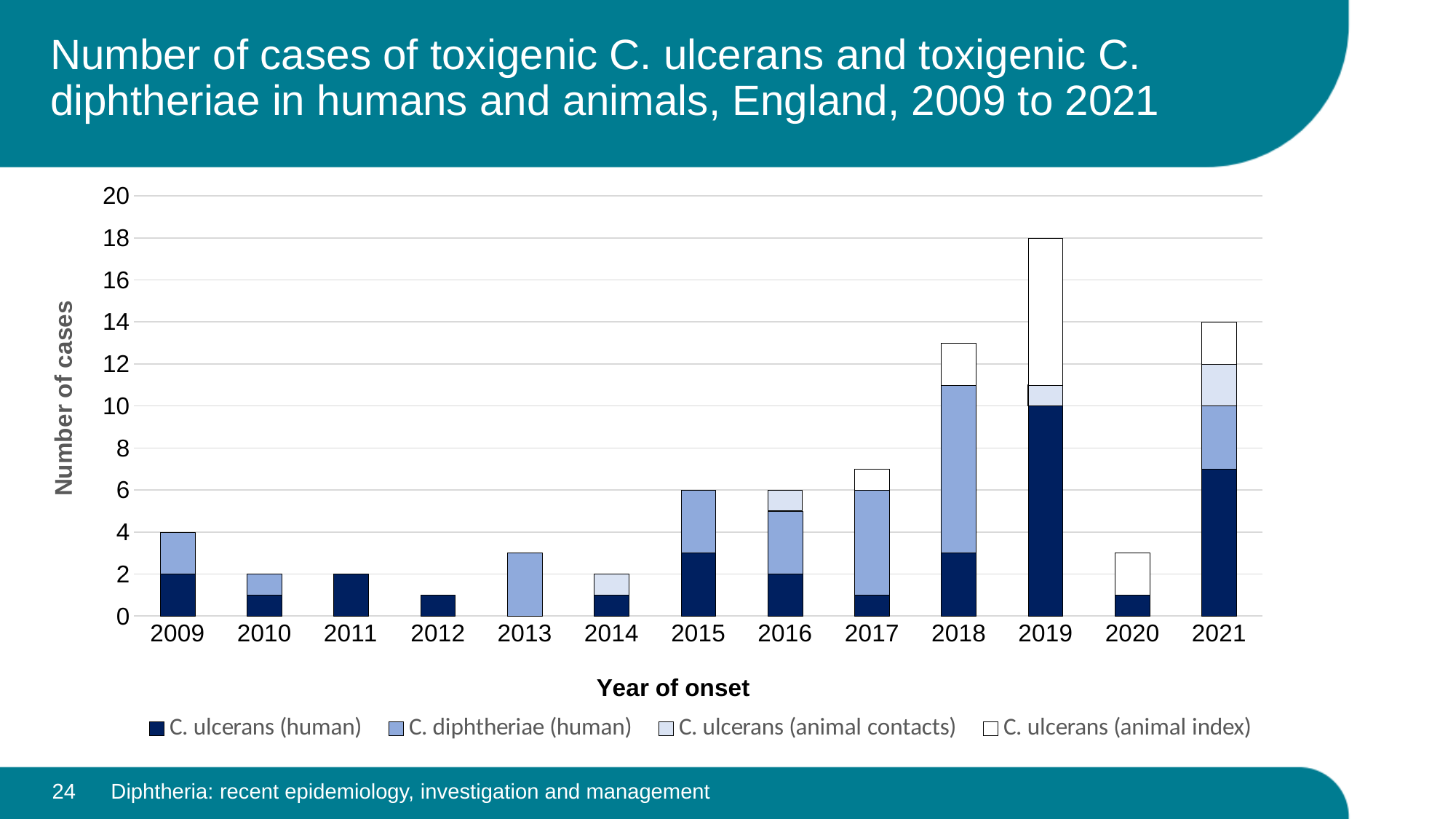
What is the total number of cases in 2021? 14 Which year has a higher total number of cases, 2019 or 2021? 2019 Which year has the lowest total number of cases? 2012 Is the total number of cases in 2018 greater or less than 12? greater How many series does the legend list? 4 What is the total number of cases in 2015? 6 How many years are shown on the x axis? 13 How many C. ulcerans (human) cases were there in 2011? 2 What is the total number of cases in 2019? 18 Which year has the highest total number of cases? 2019 How many C. ulcerans (human) cases were there in 2019? 10 What kind of chart is shown on the slide? Stacked bar chart